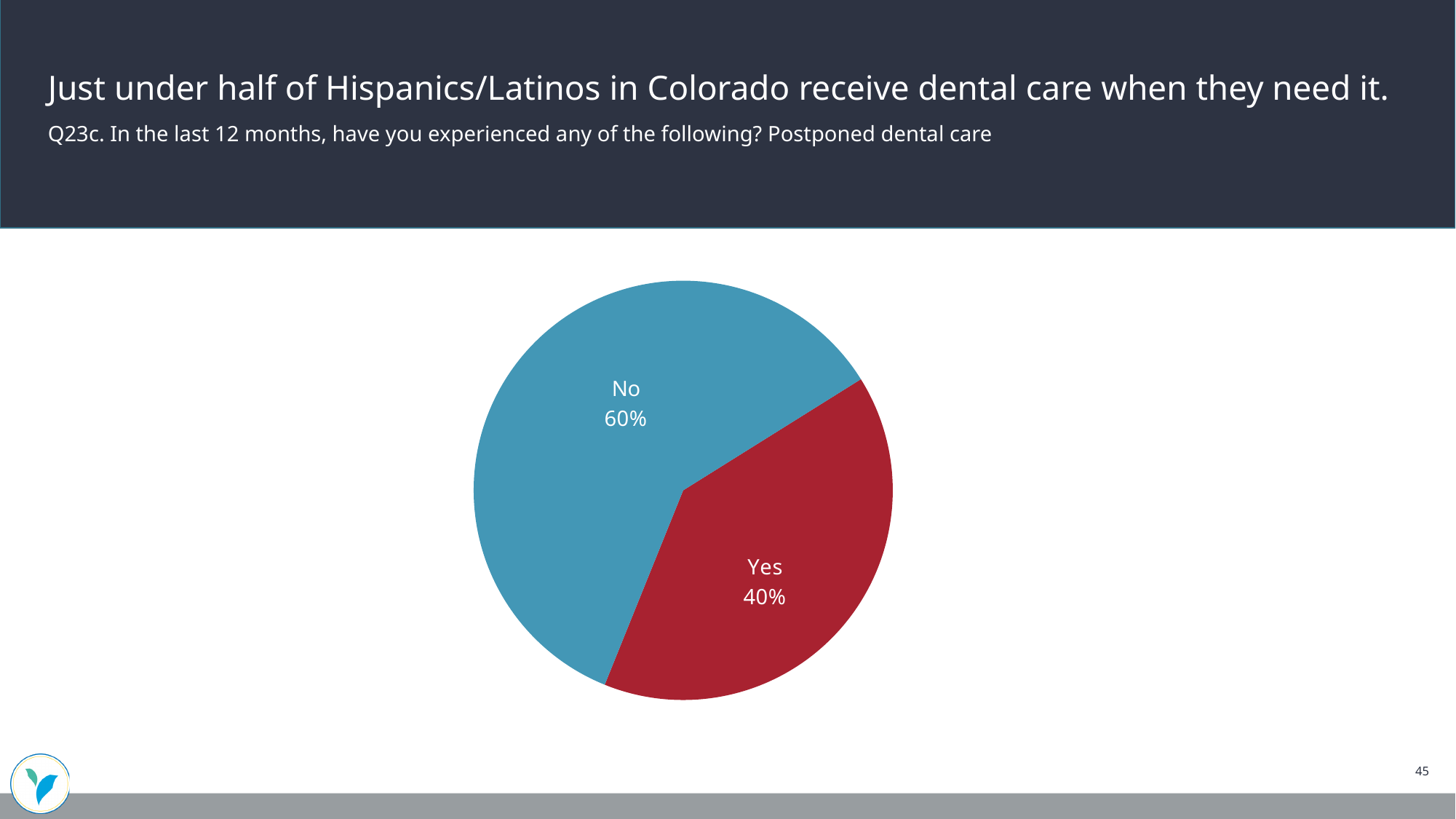
What percentage of respondents answered "Yes"? 40% What share of the pie does the "Yes" slice represent? 40% Which slice is larger, "Yes" or "No"? No What is the difference in percentage points between the "No" and "Yes" slices? 20 What kind of chart is shown on the slide? Pie chart What colour is the "Yes" slice? Red Which response has the largest share of the pie? No What survey question does the chart report on? Q23c. In the last 12 months, have you experienced any of the following? Postponed dental care Which response has the smallest share of the pie? Yes What percentage of respondents answered "No"? 60% How many slices does the pie chart have? 2